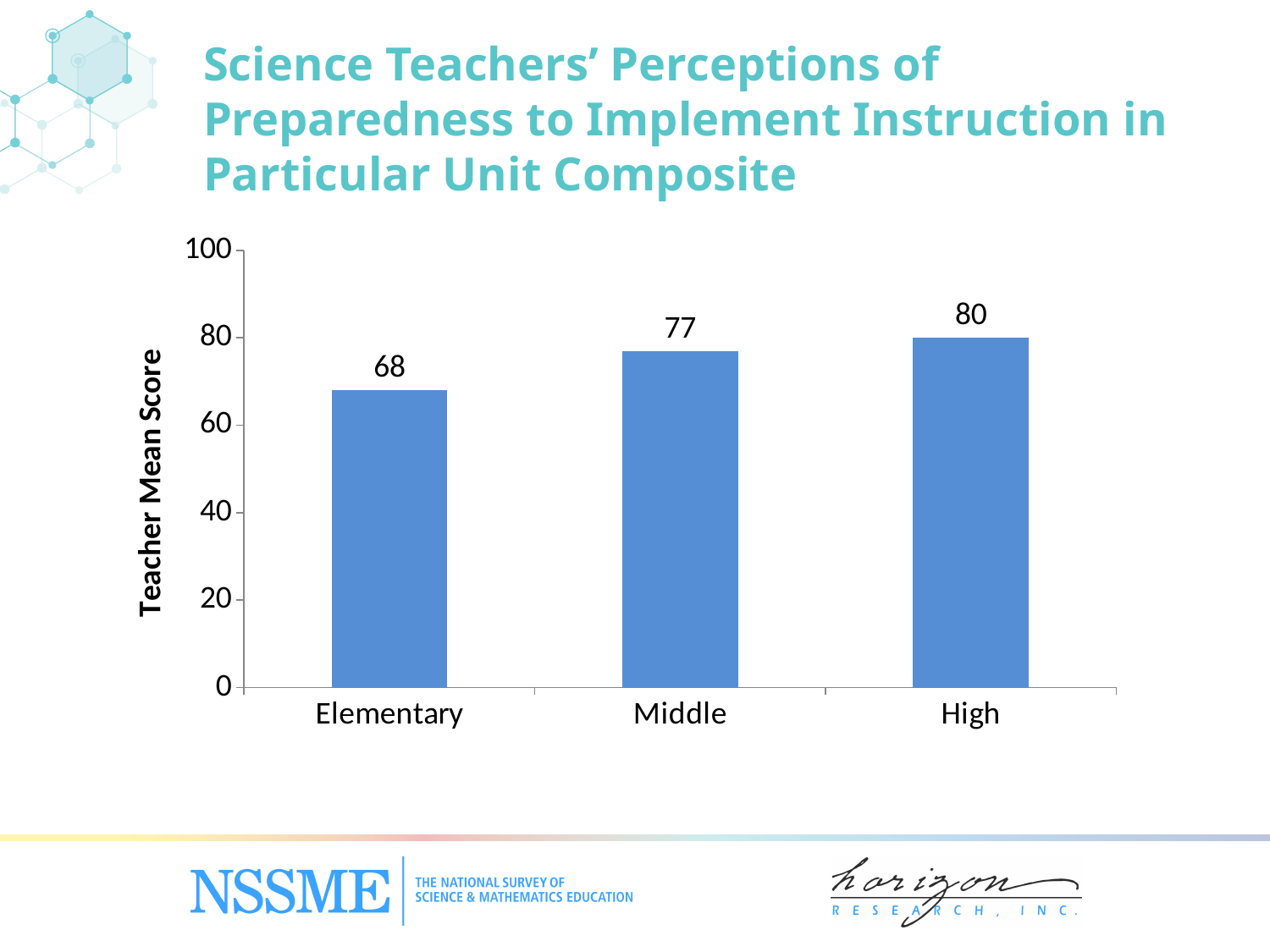
How many grade-level categories are shown on the chart? 3 What kind of chart is shown on the slide? Bar chart Which grade level has the highest teacher mean score? High Which has a higher teacher mean score, Elementary or Middle? Middle What is the difference between the teacher mean scores for High and Elementary? 12 What is the teacher mean score for High? 80 Is the teacher mean score for Elementary greater or less than 80? less What is the teacher mean score for Elementary? 68 What is the label of the vertical axis? Teacher Mean Score What is the difference between the teacher mean scores for Middle and Elementary? 9 Which grade level has the lowest teacher mean score? Elementary What is the teacher mean score for Middle? 77